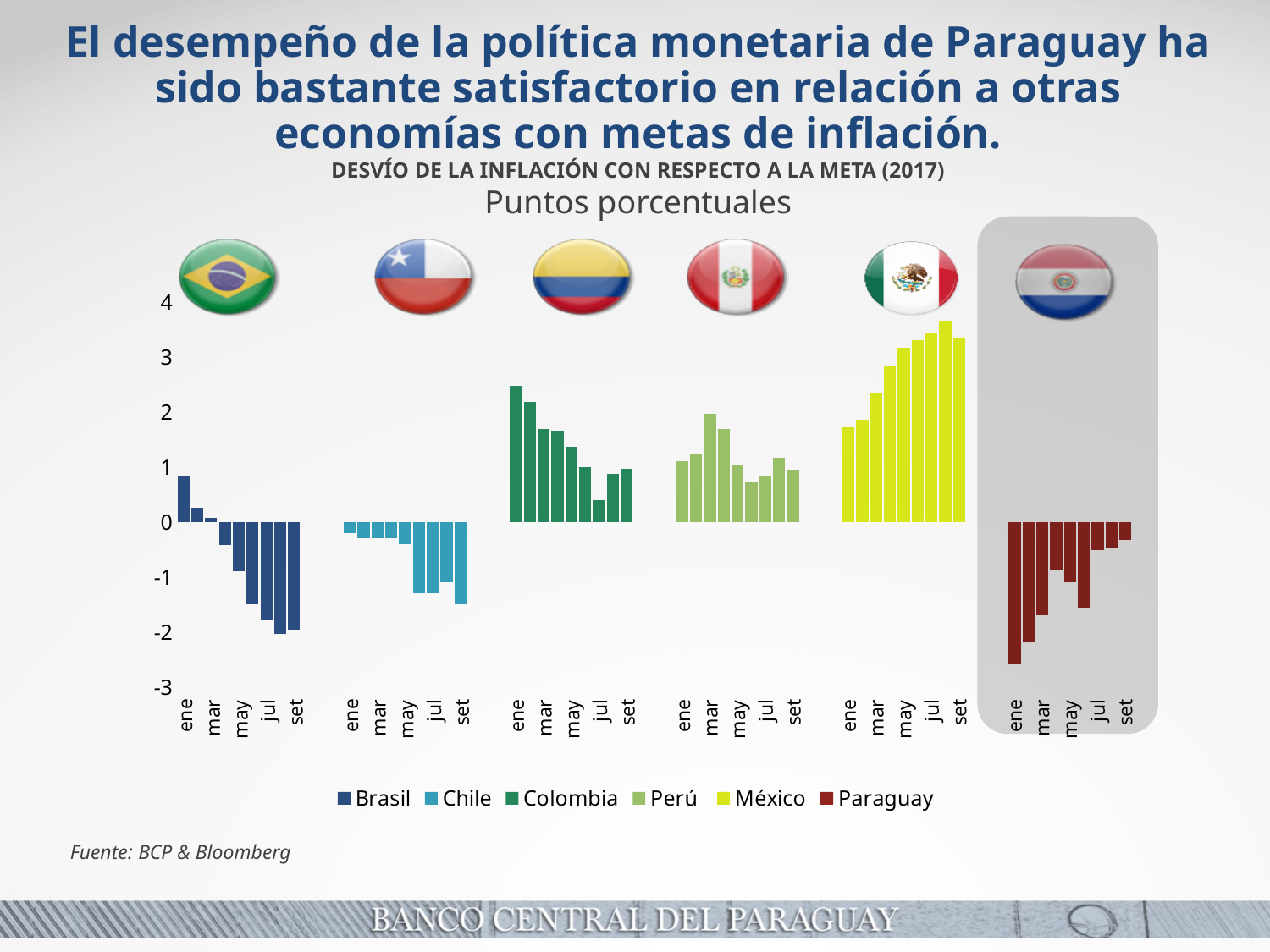
Is the value for Paraguay in ene greater or less than -2? less Do the values for Brasil rise or fall from ene to set? fall How many series does the legend list? 6 Is the value for México in jul greater or less than 3? greater Which is larger, the value for Colombia in ene or the value for Perú in ene? Colombia in ene Do the values for México rise or fall from ene to set? rise Which countries are listed in the legend? Brasil, Chile, Colombia, Perú, México, Paraguay Which country has the highest bar in the chart? México What kind of chart is shown on the slide? bar chart Which country has the lowest bar in the chart? Paraguay Is the value for Colombia in ene greater or less than 2? greater What is the title of the chart? DESVÍO DE LA INFLACIÓN CON RESPECTO A LA META (2017)